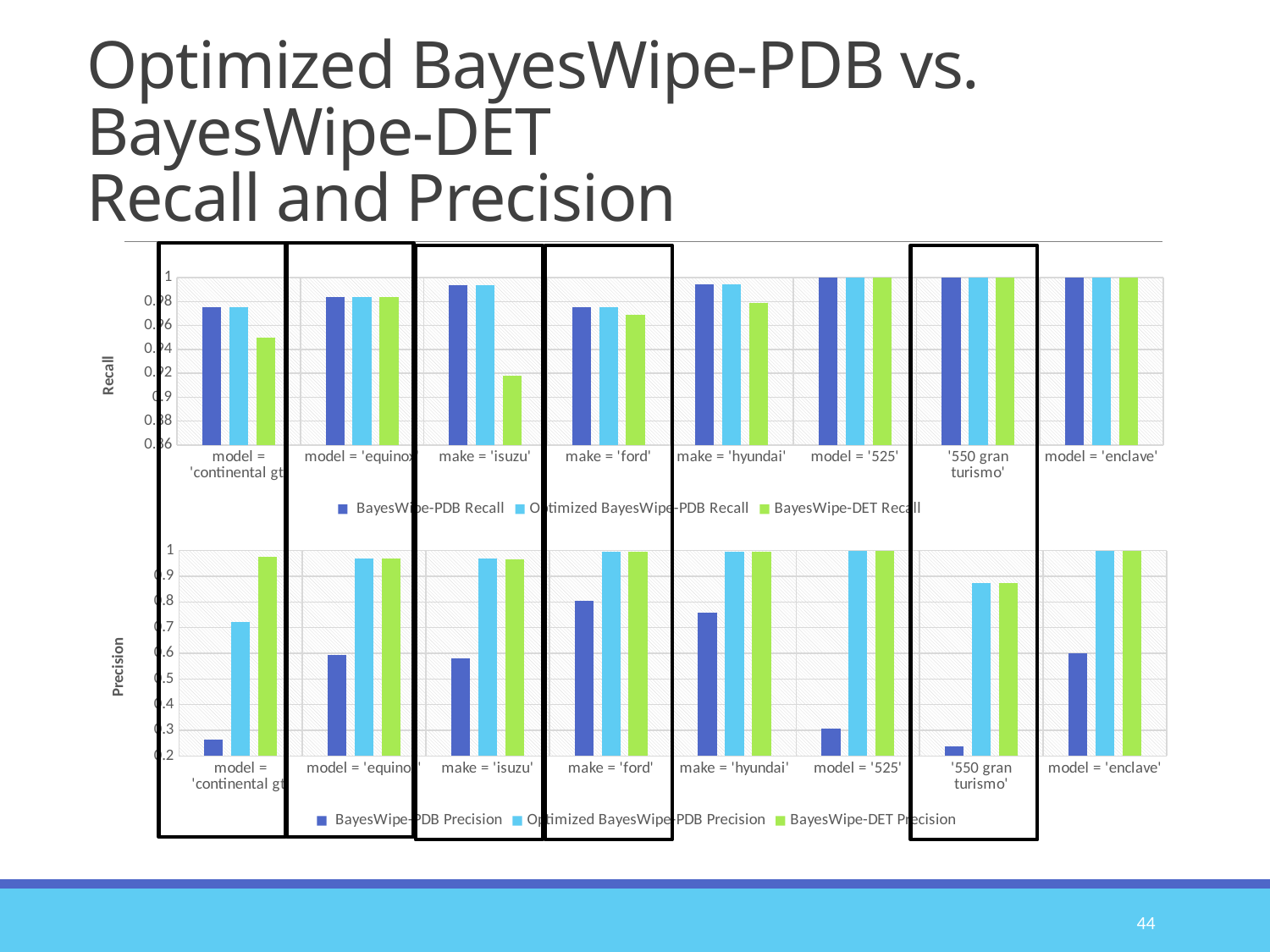
How many series does the legend of the Recall chart list? 3 What kind of chart is the top chart labelled Recall? bar chart What is the label on the vertical axis of the bottom chart? Precision How many categories are shown on the x axis of the Precision chart? 8 In the Recall chart, which is larger: the BayesWipe-PDB Recall for make = 'isuzu' or for make = 'ford'? make = 'isuzu' In the Precision chart, which is larger: the BayesWipe-PDB Precision for make = 'ford' or for model = 'equinox'? make = 'ford' Which series is shown in green in the Precision chart's legend? BayesWipe-DET Precision In the Recall chart, is the BayesWipe-DET Recall for make = 'isuzu' greater or less than 0.94? less In the Recall chart, which category has the lowest BayesWipe-DET Recall? make = 'isuzu' In the Precision chart, is the BayesWipe-PDB Precision for model = 'continental gt' greater or less than 0.3? less In the Precision chart, is the BayesWipe-PDB Precision for make = 'hyundai' greater or less than 0.7? greater